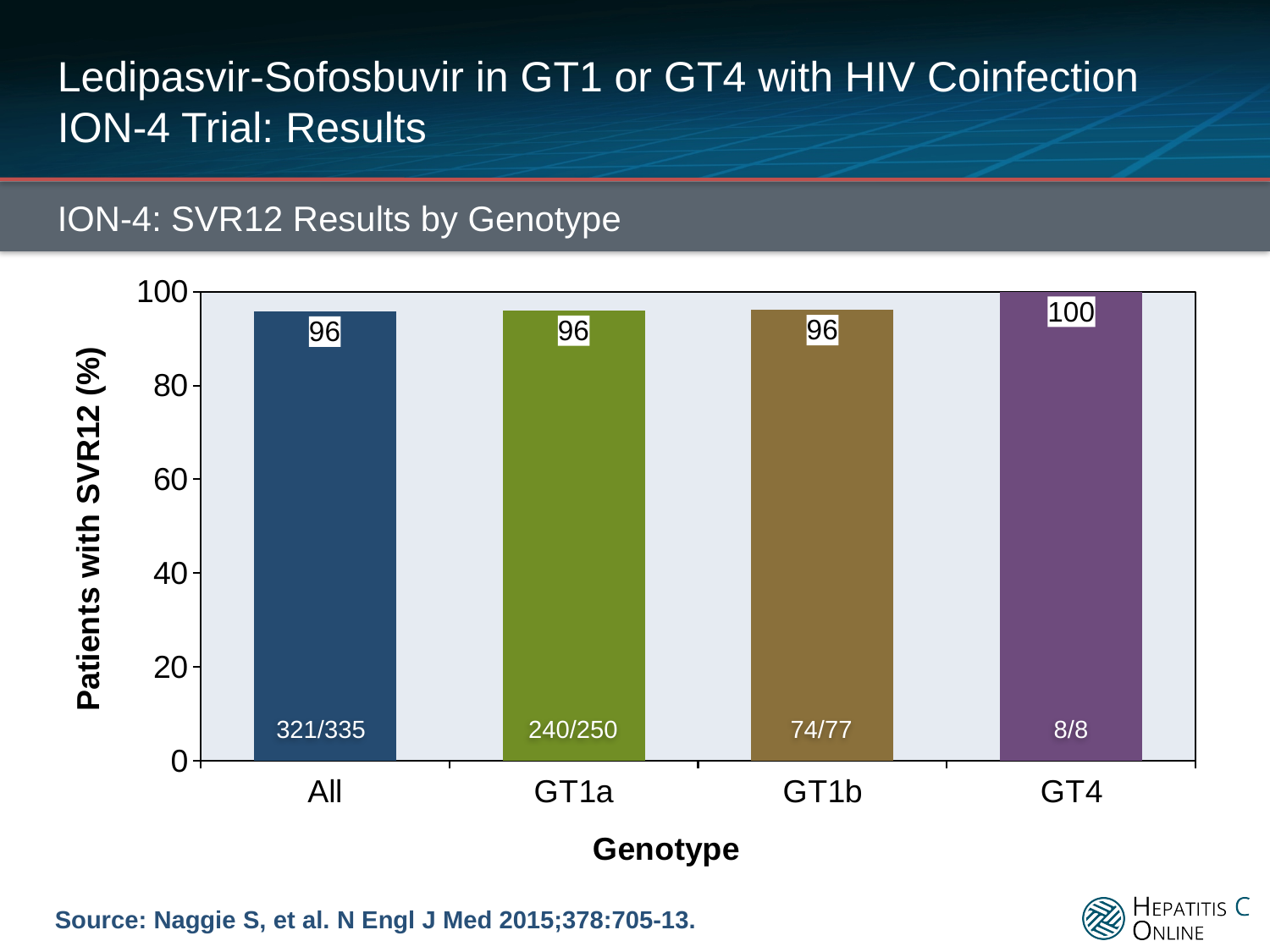
Which genotype group has the highest SVR12 rate? GT4 How many genotype categories are shown on the x axis? 4 What is the SVR12 rate for the GT4 group? 100 What fraction of patients is shown inside the GT1b bar? 74/77 What is the SVR12 rate for the All group? 96 What kind of chart is shown on the slide? Bar chart What is the label of the y axis? Patients with SVR12 (%) Is the SVR12 rate for GT1b greater or less than 80? greater What fraction of patients is shown inside the All bar? 321/335 Which has a higher SVR12 rate, GT4 or GT1a? GT4 What is the difference in SVR12 rate between GT4 and GT1b? 4 What is the SVR12 rate for the GT1a group? 96